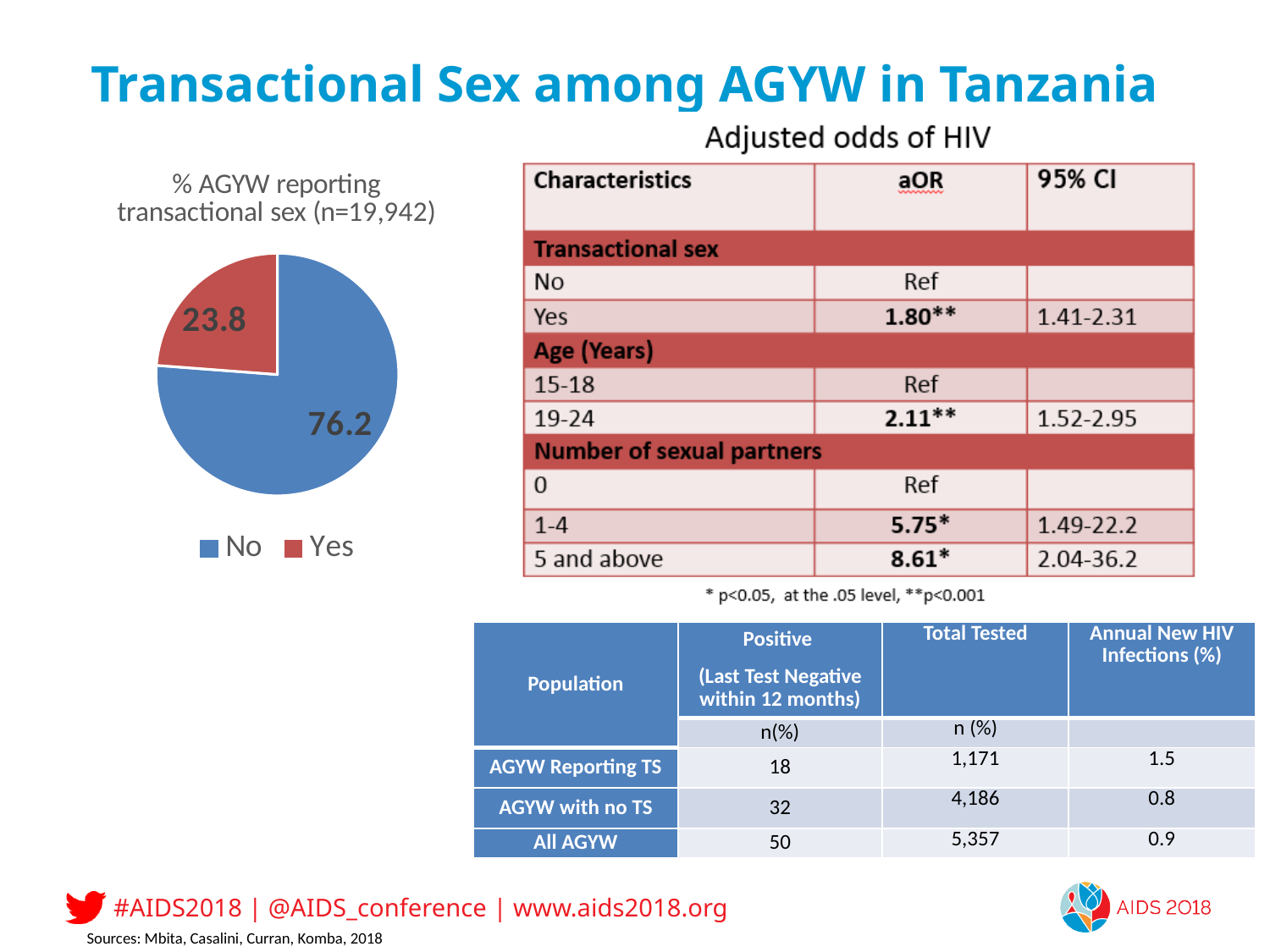
What colour is the "Yes" slice in the pie chart? red How many slices does the pie chart have? 2 What is the title of the pie chart? % AGYW reporting transactional sex (n=19,942) Which slice of the pie chart is the smallest? Yes What is the value for "No" in the pie chart? 76.2 What is the sample size (n) given in the pie chart title? 19,942 Which slice of the pie chart is the largest? No What is the value for "Yes" in the pie chart? 23.8 How many entries does the pie chart legend list? 2 Which is larger in the pie chart, "No" or "Yes"? No What kind of chart is shown on the slide? pie chart What is the difference between the "No" and "Yes" values in the pie chart? 52.4